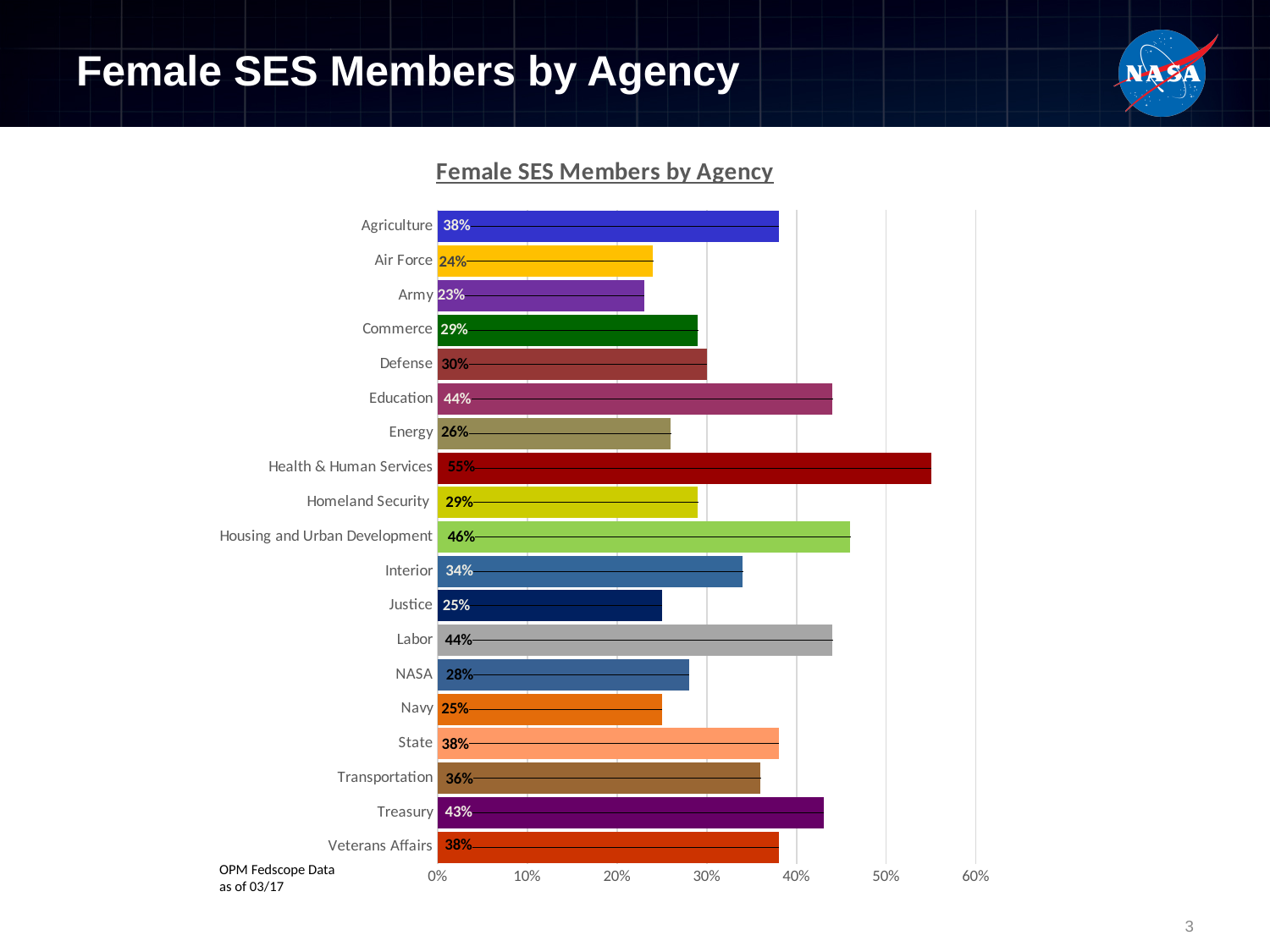
Which agency has the highest percentage of female SES members? Health & Human Services What is the value for NASA? 28% What is the difference between the values for Treasury and NASA? 15% What is the title of the chart? Female SES Members by Agency How many agencies are shown in the chart? 19 What is the difference between the values for Health & Human Services and Army? 32% Is the value for Labor greater or less than 40%? greater What is the value for Housing and Urban Development? 46% Which is larger, the value for Education or the value for Interior? Education What kind of chart is shown on the slide? Bar chart What is the value for Health & Human Services? 55% Which agency has the lowest percentage of female SES members? Army